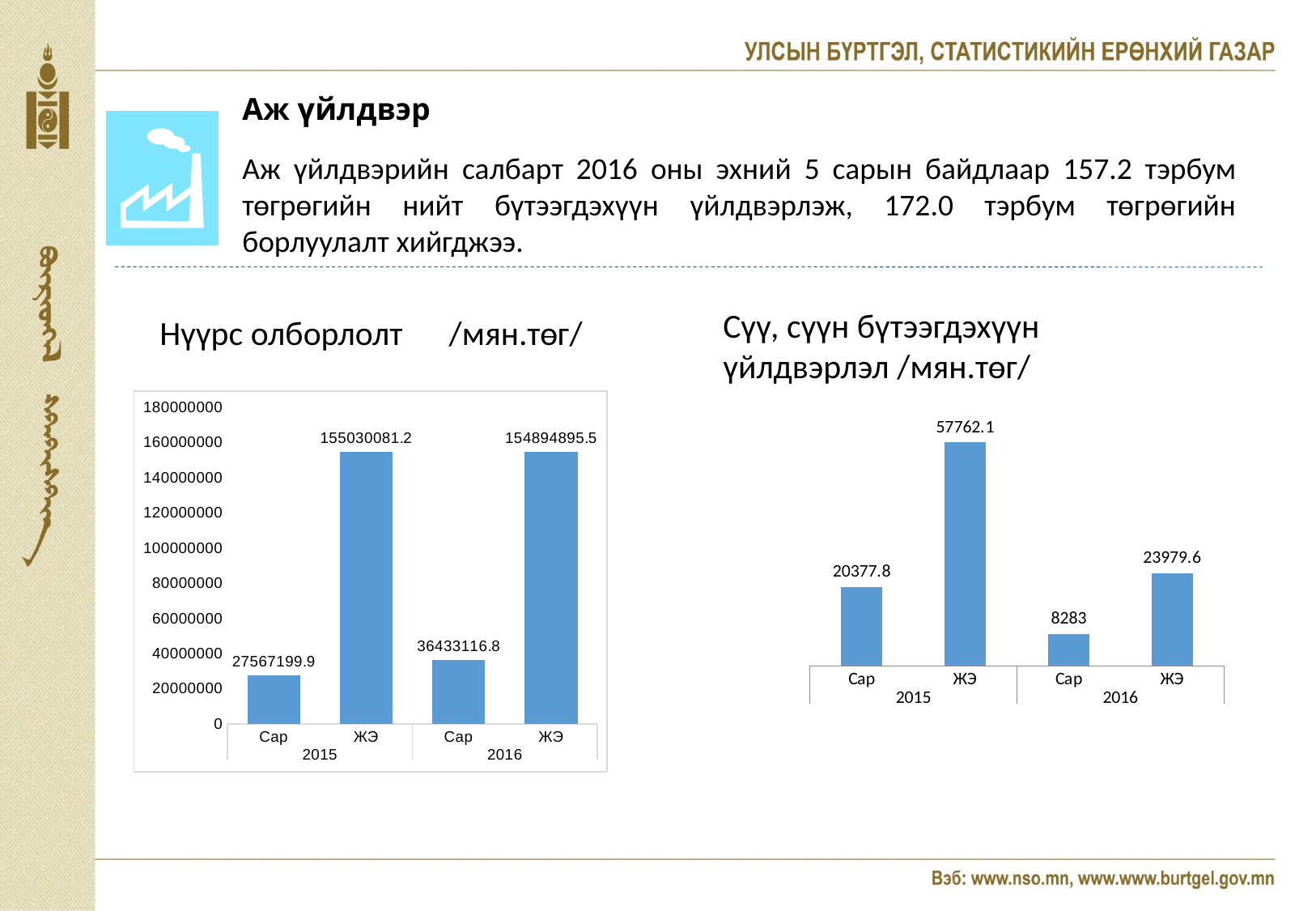
In the chart titled 'Сүү, сүүн бүтээгдэхүүн үйлдвэрлэл /мян.төг/', which bar is the highest? ЖЭ 2015 In the chart titled 'Нүүрс олборлолт /мян.төг/', what is the value for ЖЭ in 2016? 154894895.5 In the chart titled 'Нүүрс олборлолт /мян.төг/', which bar is the lowest? Сар 2015 In the chart titled 'Сүү, сүүн бүтээгдэхүүн үйлдвэрлэл /мян.төг/', what is the value for ЖЭ in 2015? 57762.1 In the chart titled 'Нүүрс олборлолт /мян.төг/', what is the difference between the Сар values for 2016 and 2015? 8865916.9 In the chart titled 'Сүү, сүүн бүтээгдэхүүн үйлдвэрлэл /мян.төг/', which is larger: Сар 2015 or Сар 2016? Сар 2015 What kind of chart is the 'Сүү, сүүн бүтээгдэхүүн үйлдвэрлэл /мян.төг/' chart? bar chart In the chart titled 'Нүүрс олборлолт /мян.төг/', how many bars are plotted? 4 In the chart titled 'Нүүрс олборлолт /мян.төг/', what is the value for Сар in 2015? 27567199.9 In the chart titled 'Сүү, сүүн бүтээгдэхүүн үйлдвэрлэл /мян.төг/', what is the value for Сар in 2016? 8283 In the chart titled 'Сүү, сүүн бүтээгдэхүүн үйлдвэрлэл /мян.төг/', what is the difference between ЖЭ 2016 and Сар 2016? 15696.6 In the chart titled 'Нүүрс олборлолт /мян.төг/', is the value for Сар in 2016 greater or less than 40000000? less